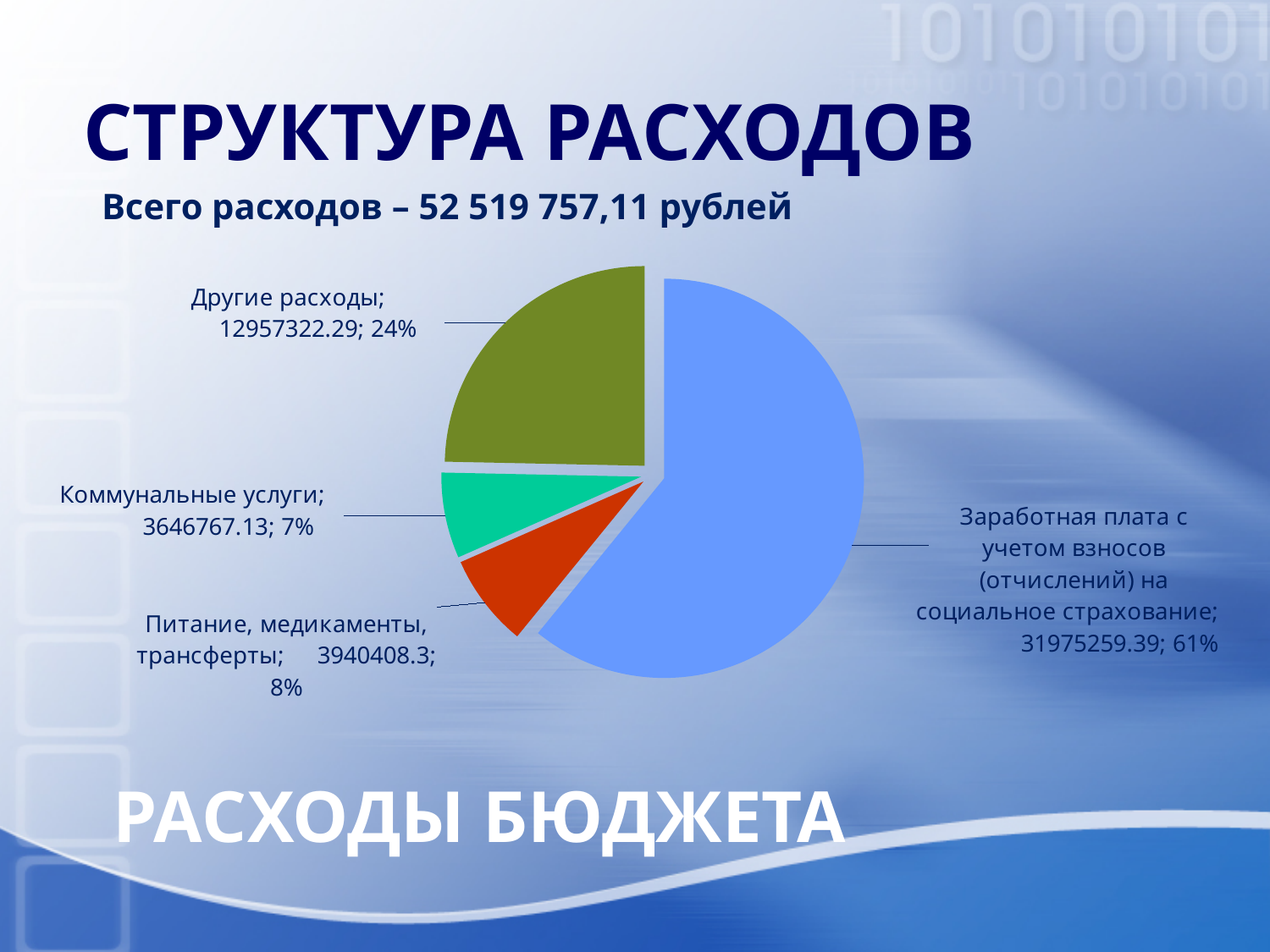
What kind of chart is shown on the slide? pie chart What is the value shown for Другие расходы? 12957322.29 What is the difference between the values for Питание, медикаменты, трансферты and Коммунальные услуги? 293641.17 Which category has the smallest slice of the pie? Коммунальные услуги Which is larger: the value for Питание, медикаменты, трансферты or the value for Коммунальные услуги? Питание, медикаменты, трансферты What total expenditure amount is stated above the chart? 52 519 757,11 рублей How many slices does the pie chart have? 4 What is the difference in percentage share between Заработная плата с учетом взносов (отчислений) на социальное страхование and Другие расходы? 37 percentage points Which category has the largest slice of the pie? Заработная плата с учетом взносов (отчислений) на социальное страхование What is the value shown for Питание, медикаменты, трансферты? 3940408.3 What percentage share is shown for Коммунальные услуги? 7% What percentage share is shown for Заработная плата с учетом взносов (отчислений) на социальное страхование? 61%